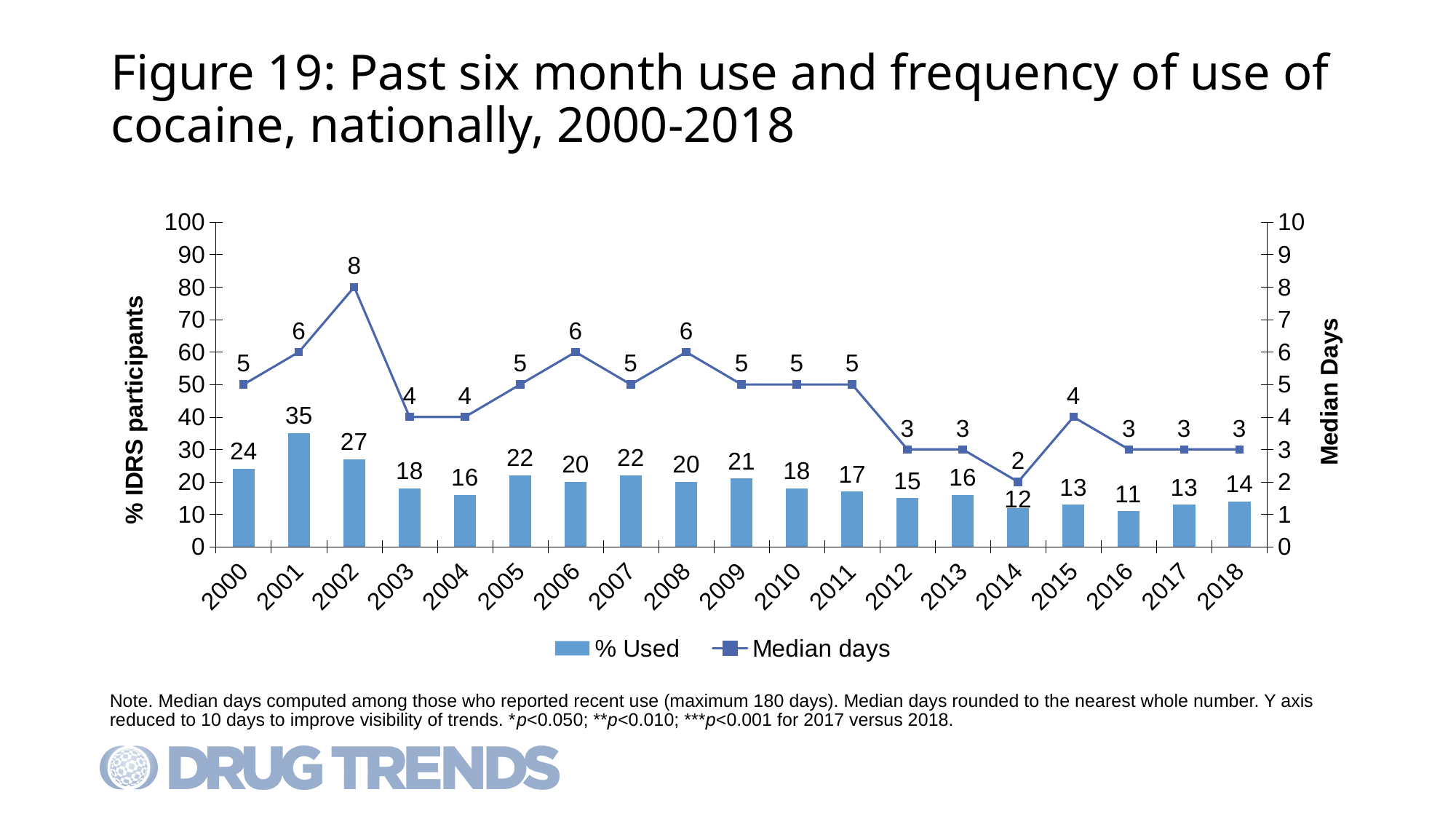
What is the label of the right-hand y axis? Median Days What kind of chart is used for the % Used series? bar chart Which year has the highest % Used value? 2001 How many years are shown on the x axis? 19 What is the Median days value for 2002? 8 Which is larger, the % Used value for 2000 or for 2002? 2002 What is the % Used value for 2018? 14 What is the % Used value for 2001? 35 Which year has the lowest Median days value? 2014 Which year has the lowest % Used value? 2016 How many series does the legend list? 2 What is the difference between the % Used values for 2001 and 2016? 24